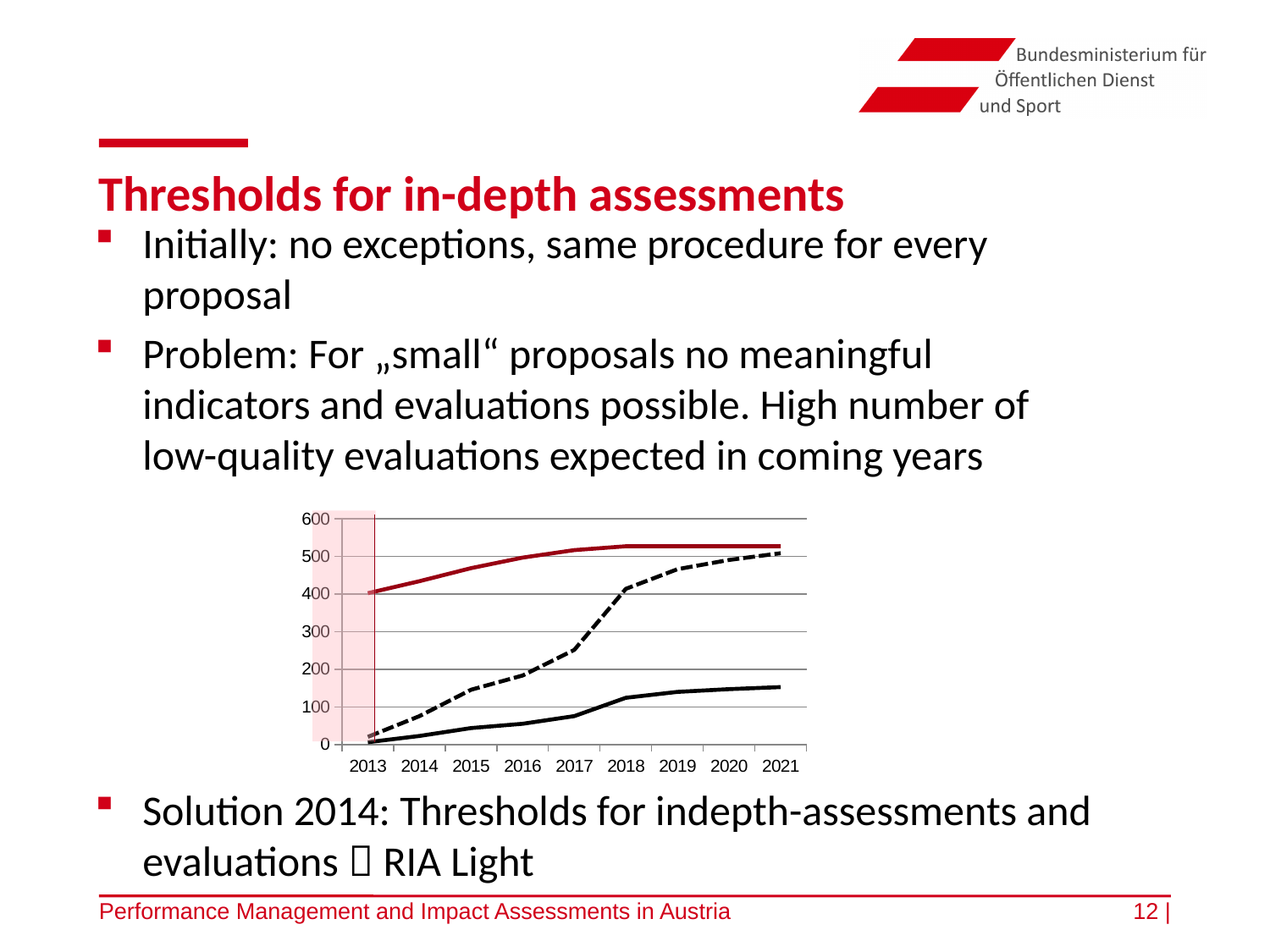
Is the value of the black dashed line in 2017 greater or less than 300? less How many years are shown on the x axis of the chart? 9 Which line has the highest value in 2016? the dark red solid line Is the value of the black solid line in 2013 greater or less than 100? less What is the last year shown on the x axis of the chart? 2021 Does the black dashed line rise or fall from 2013 to 2021? rise Is the value of the black solid line in 2021 greater or less than 200? less What is the first year shown on the x axis of the chart? 2013 In 2018, which is higher: the black dashed line or the black solid line? the black dashed line Does the dark red solid line rise or fall from 2013 to 2021? rise What kind of chart is shown on the slide? line chart